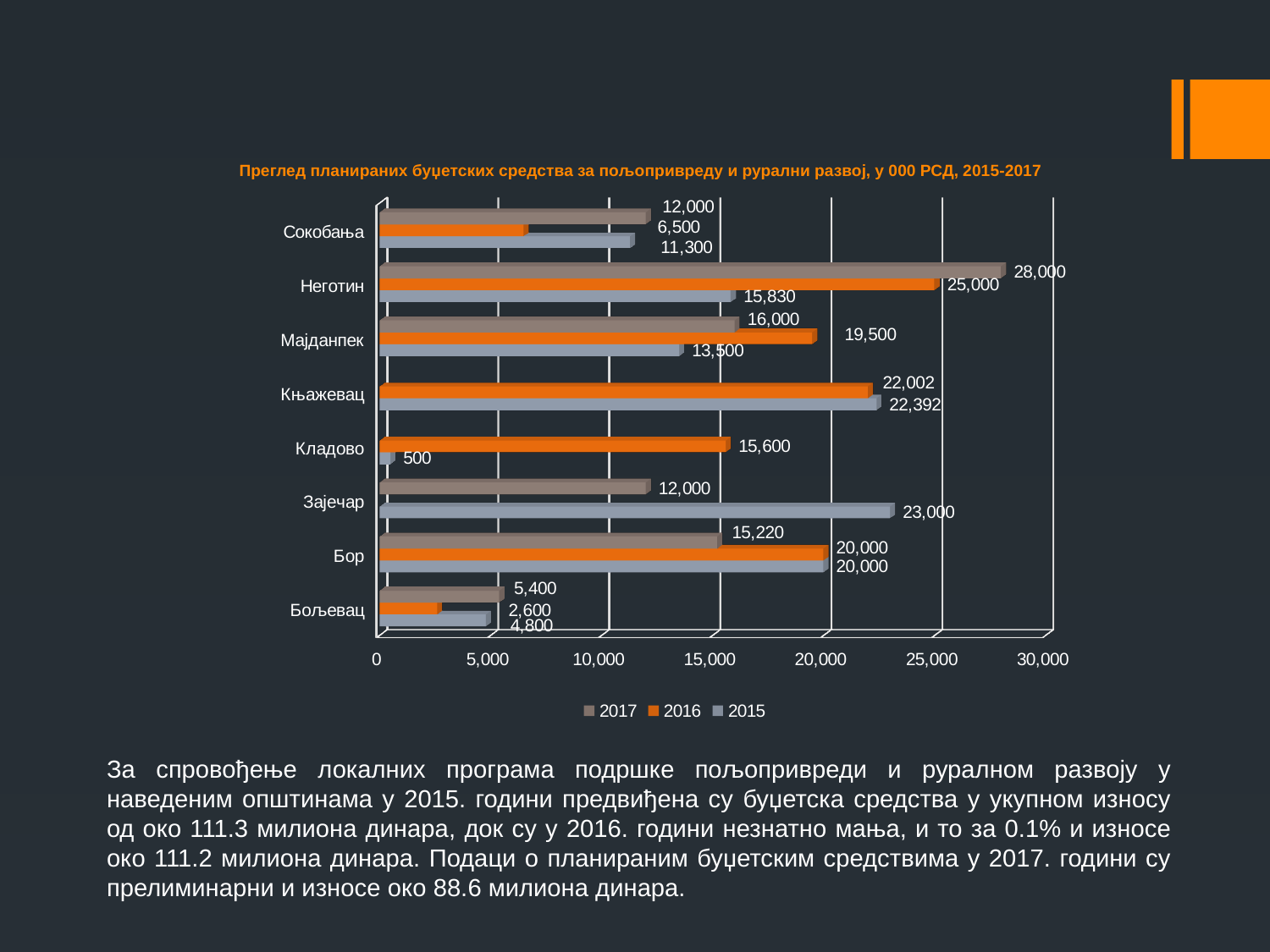
What is the planned budget for Неготин in 2017? 28,000 How many municipalities are shown on the chart? 8 What is the difference between the 2015 and 2017 values for Зајечар? 11,000 What type of chart is shown on the slide? Bar chart For Мајданпек, which year has the larger value, 2016 or 2017? 2016 Which municipality has the highest value in the 2017 series? Неготин Which municipality has the lowest value in the 2015 series? Кладово What is the value for Сокобања in the 2016 series? 6,500 What is the value for Кладово in 2015? 500 What is the difference between the 2017 and 2016 values for Неготин? 3,000 How many series does the legend list? 3 What is the value for Бор in 2016? 20,000